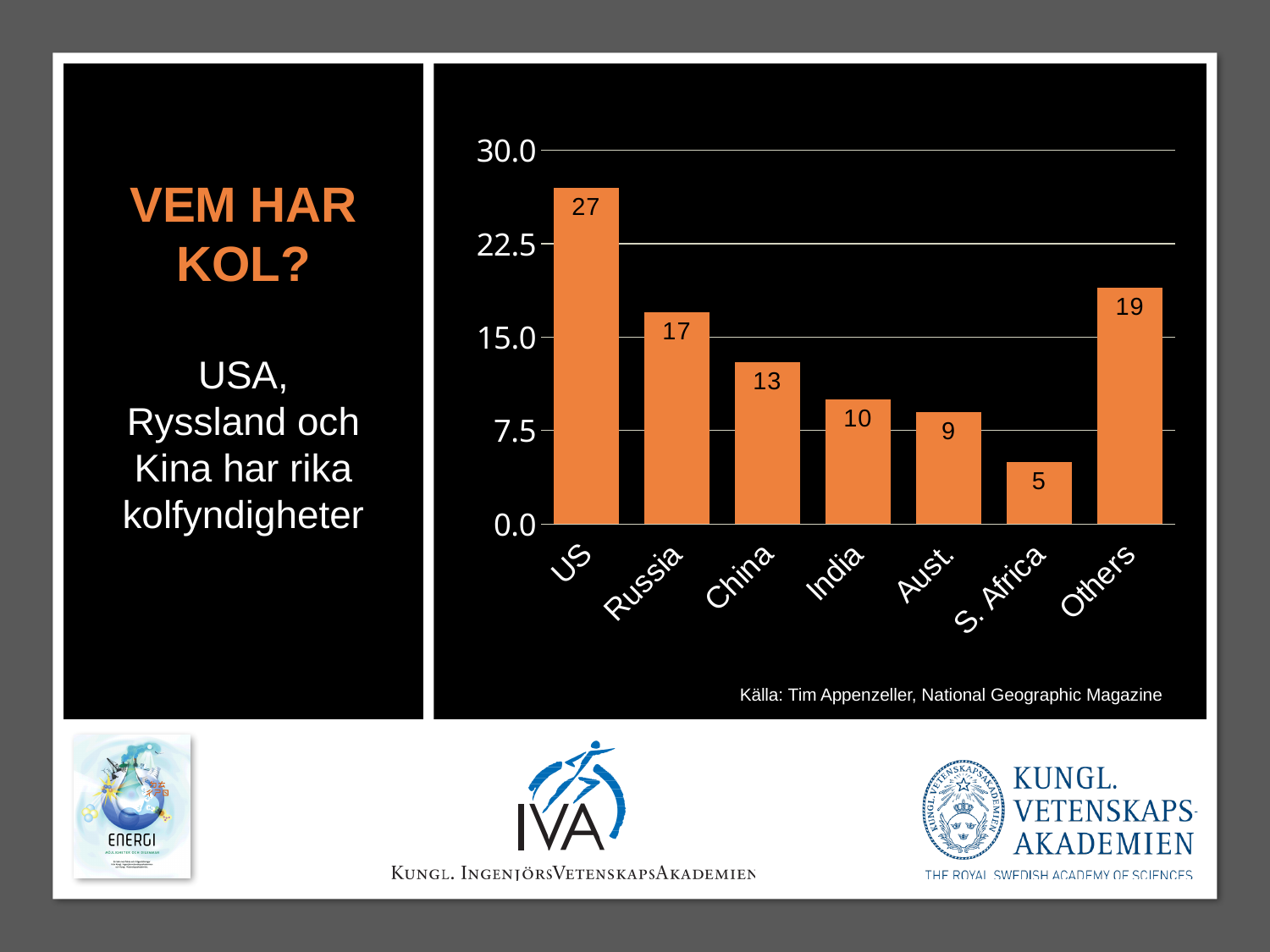
What is the value for Russia? 17 What is the value for S. Africa? 5 What is the value for Others? 19 What kind of chart is shown on the slide? Bar chart How many categories are shown on the x axis? 7 What is the value for the US? 27 Is the value for Others greater or less than 15.0? greater Which category has the highest value? US Which is larger, the value for India or the value for Aust.? India Which category has the lowest value? S. Africa What is the difference between the values for the US and China? 14 What is the source cited below the chart? Tim Appenzeller, National Geographic Magazine